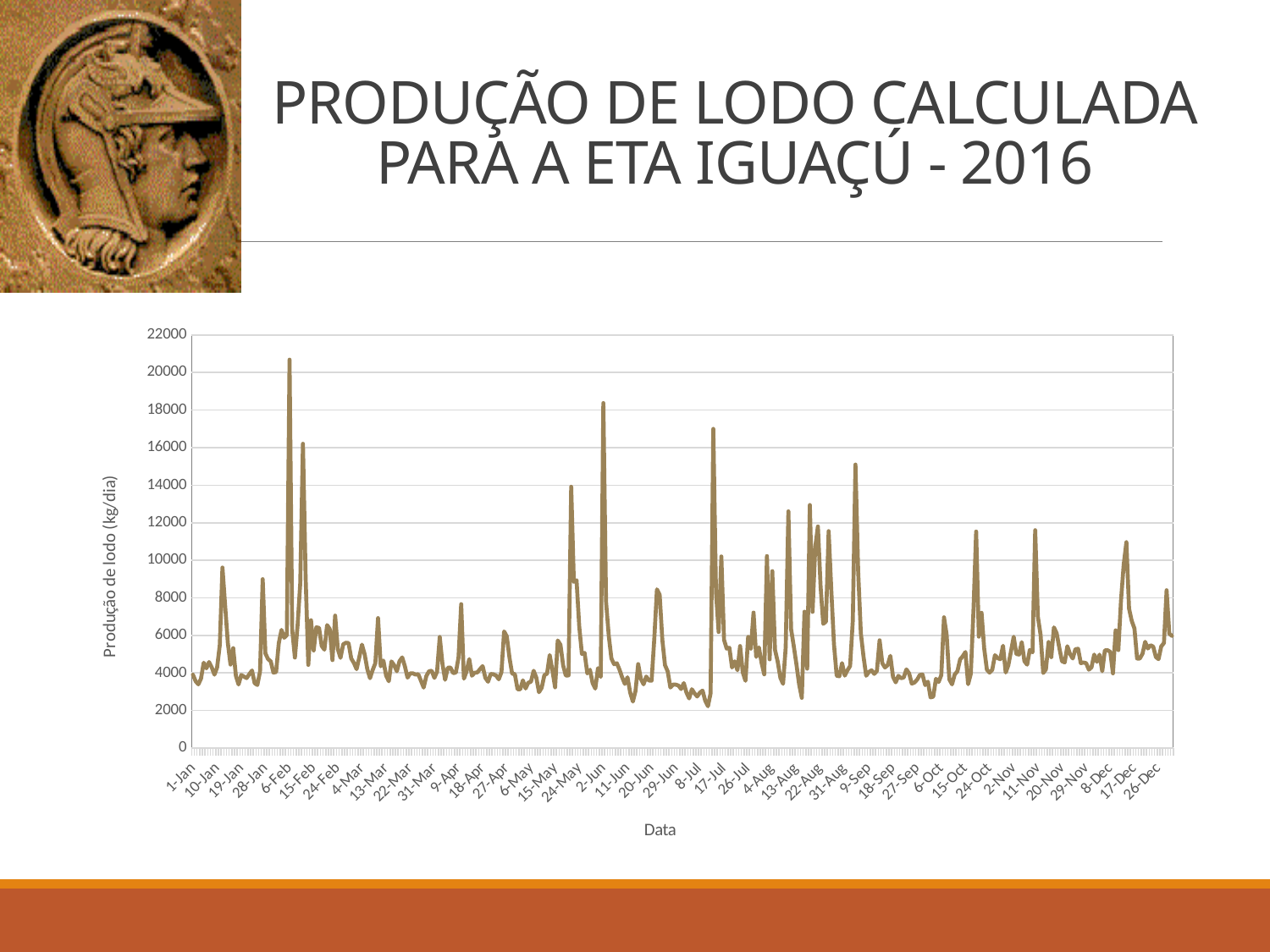
What kind of chart is shown on the slide? line chart In which month does the highest peak of the line occur? February Is the value at 1-Jan greater or less than 6000? less Is the lowest value of the line, in the dip between 8-Jul and 17-Jul, greater or less than 4000? less Is the peak near 24-May greater or less than 12000? greater Which is larger: the peak in early February or the peak near 2-Jun? the peak in early February What is the label of the horizontal axis of the chart? Data What is the label of the vertical axis of the chart? Produção de lodo (kg/dia) Which is larger: the peak near 17-Jul or the peak near 9-Sep? the peak near 17-Jul